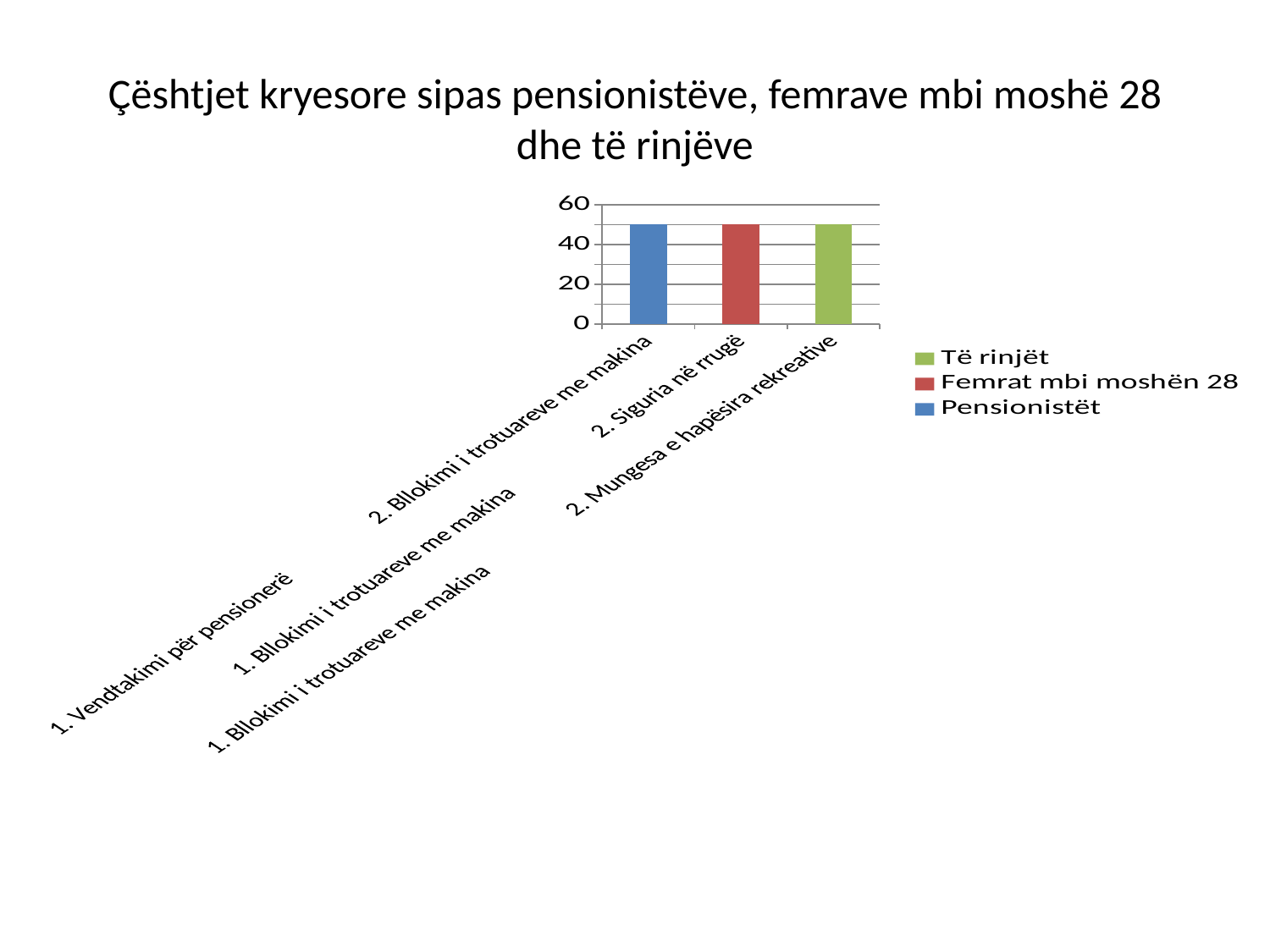
How many series does the legend list? 3 How many bars are plotted in the chart? 3 Do the three bars in the chart reach the same height? yes What is the highest value shown on the vertical axis? 60 Is the value of the blue bar (Pensionistët) greater or less than 40? greater What kind of chart is shown on the slide? bar chart Is the value of the green bar (Të rinjët) greater or less than 20? greater Which colour represents the series 'Të rinjët' in the legend? green Is the value of the red bar (Femrat mbi moshën 28) greater or less than 60? less